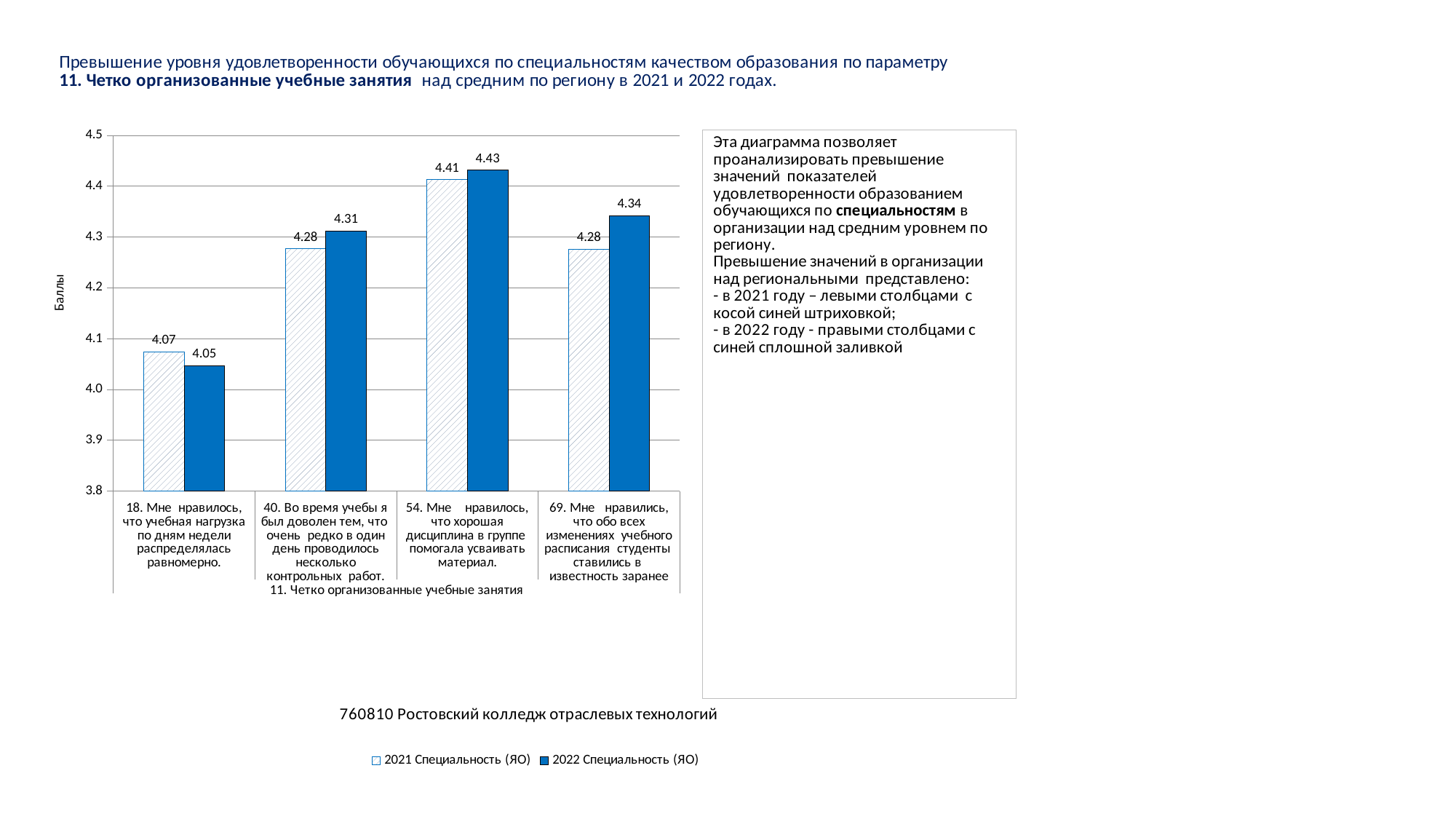
How many series does the chart legend list? 2 What kind of chart is shown on the slide? Bar chart Which category has the highest value in the 2022 Специальность (ЯО) series? 54. Мне нравилось, что хорошая дисциплина в группе помогала усваивать материал. What is the difference between the 2022 and 2021 values for category 69? 0.06 How many categories are shown on the x axis of the chart? 4 What is the value for the 2022 Специальность (ЯО) series for category 40 (Во время учебы я был доволен тем, что очень редко в один день проводилось несколько контрольных работ)? 4.31 What is the label of the vertical axis of the chart? Баллы What is the value for the 2022 Специальность (ЯО) series for category 69 (Мне нравились, что обо всех изменениях учебного расписания студенты ставились в известность заранее)? 4.34 Is the 2021 value for category 54 greater or less than 4.4? greater Which category has the lowest value in the 2021 Специальность (ЯО) series? 18. Мне нравилось, что учебная нагрузка по дням недели распределялась равномерно. What is the value for the 2021 Специальность (ЯО) series for category 18 (Мне нравилось, что учебная нагрузка по дням недели распределялась равномерно)? 4.07 For category 18, which series has the larger value: 2021 Специальность (ЯО) or 2022 Специальность (ЯО)? 2021 Специальность (ЯО)